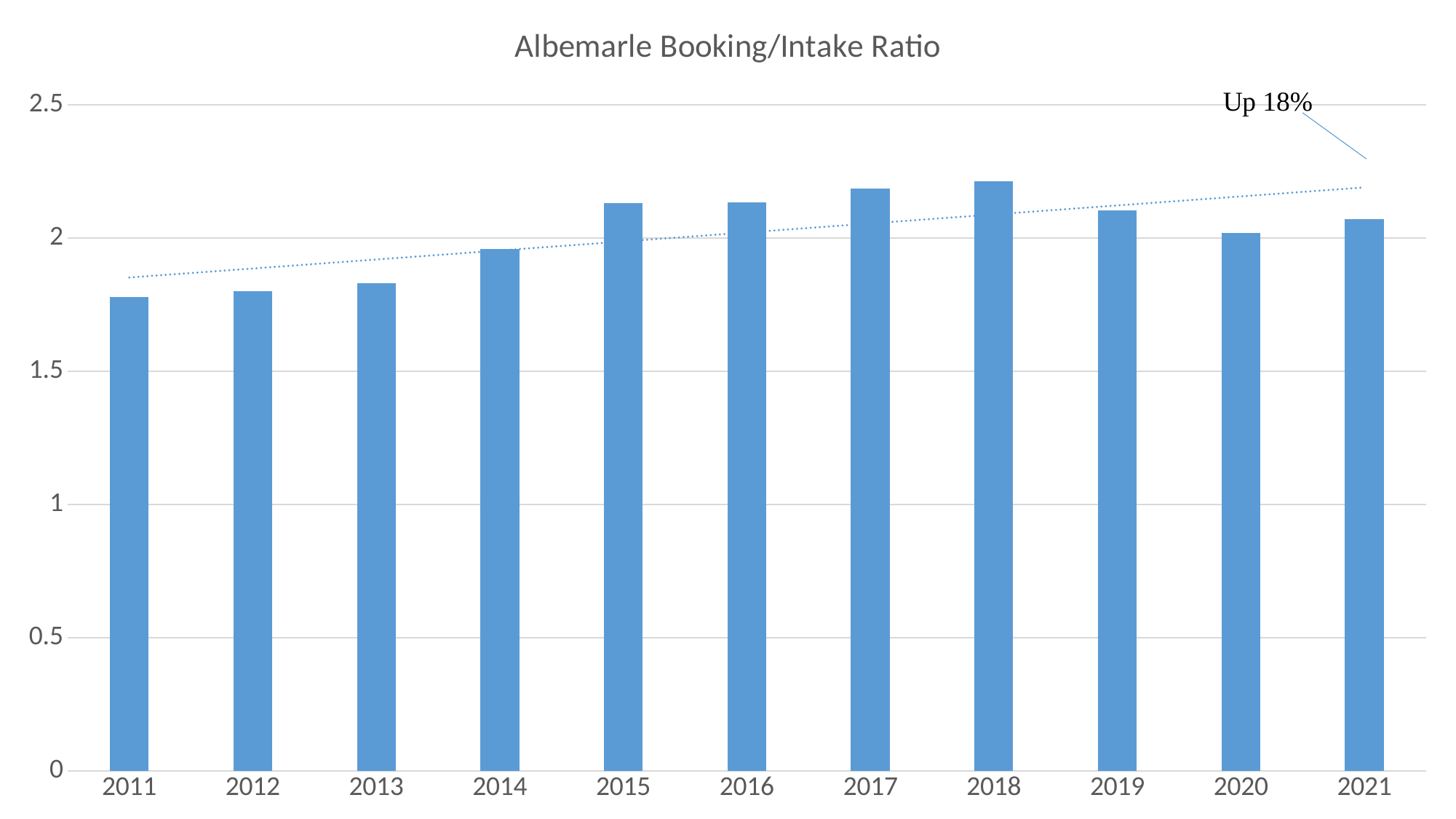
Is the value for 2018 greater or less than 2? greater What is the title of the chart? Albemarle Booking/Intake Ratio Which year has the highest booking/intake ratio? 2018 Which year has the larger value, 2011 or 2018? 2018 Do the values generally rise or fall from 2011 to 2018? rise How many years are shown on the x axis of the chart? 11 Is the value for 2011 greater or less than 2? less What kind of chart is shown on the slide? bar chart Is the value for 2013 greater or less than 2? less Which year has the larger value, 2019 or 2020? 2019 What percentage change does the annotation on the chart state? Up 18%